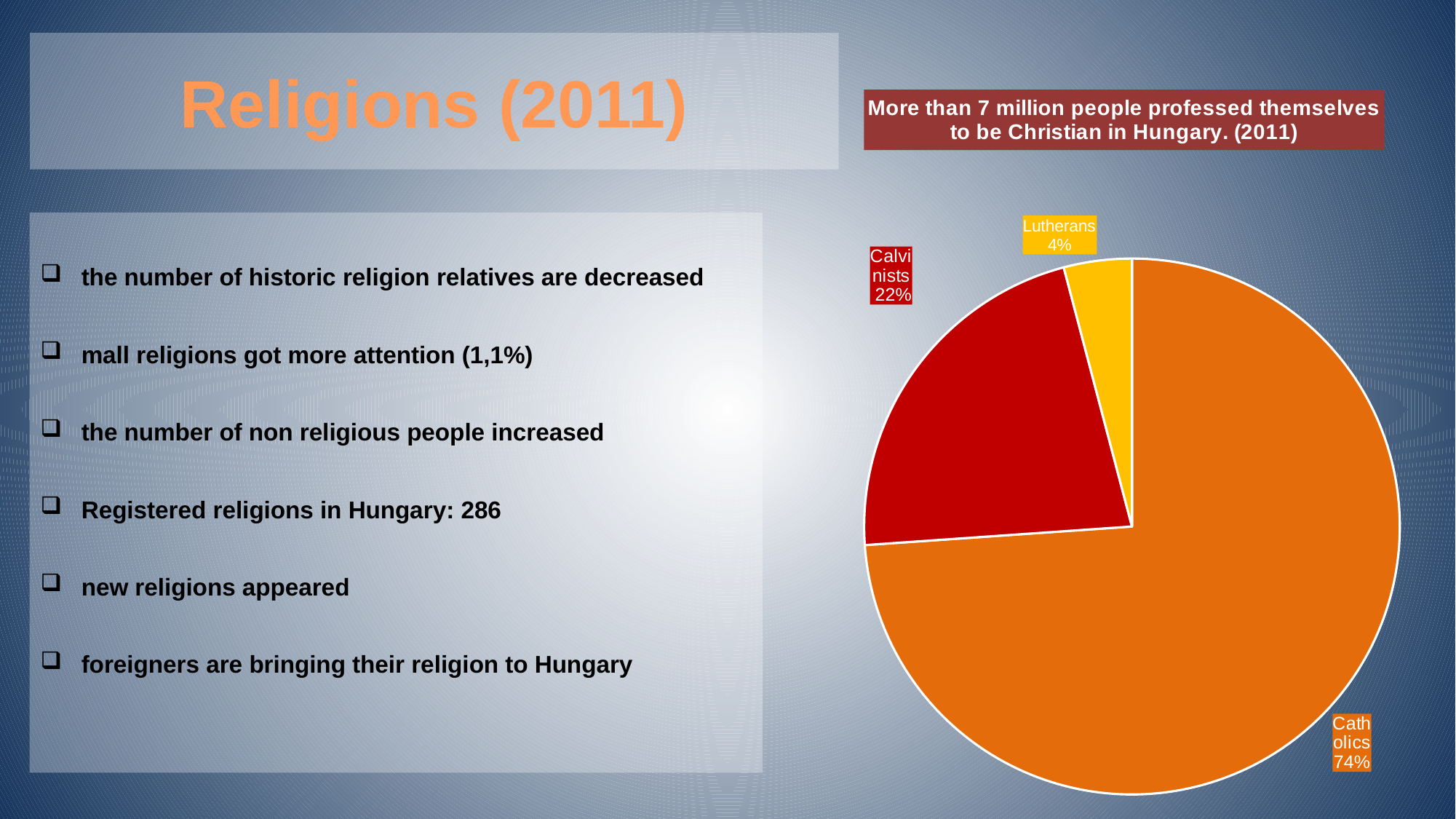
What is the difference in percentage points between the Catholics and Calvinists slices? 52 What share of the pie do Catholics represent? 74% Which group has the smallest slice of the pie? Lutherans What colour is the Calvinists slice? red What is the difference in percentage points between the Calvinists and Lutherans slices? 18 Which group has the largest slice of the pie? Catholics What share of the pie do Lutherans represent? 4% What colour is the Lutherans slice? yellow Which slice is larger, Calvinists or Lutherans? Calvinists What kind of chart is shown on the slide? pie chart What share of the pie do Calvinists represent? 22% How many slices does the pie chart have? 3